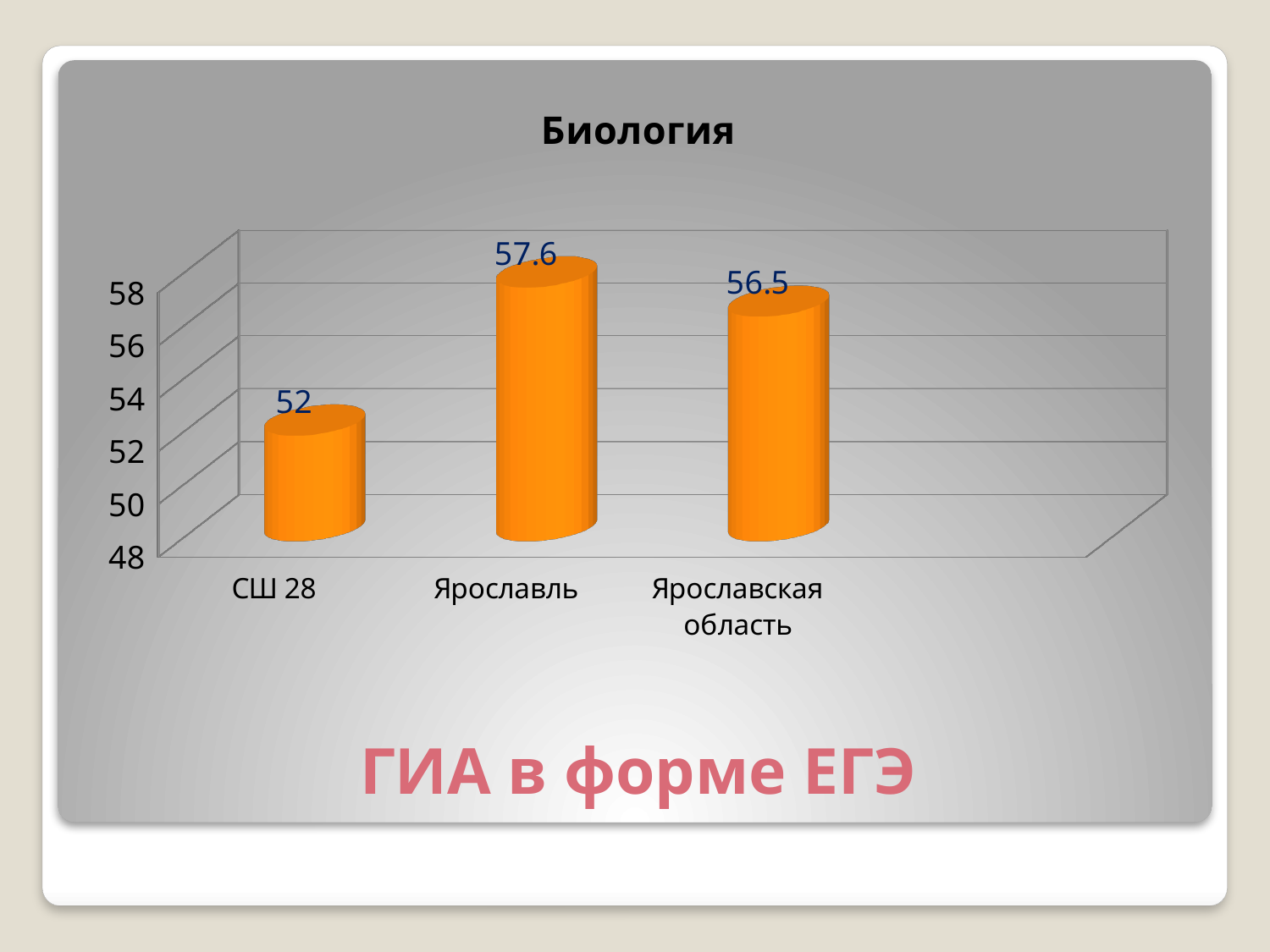
Which is larger, the value for Ярославская область or the value for СШ 28? Ярославская область Which category has the highest value? Ярославль What is the value for СШ 28? 52 Is the value for СШ 28 greater or less than 54? less What is the value for Ярославская область? 56.5 What is the title of the chart? Биология How many categories are shown on the chart? 3 What kind of chart is shown on the slide? bar chart What is the difference between the values for Ярославль and Ярославская область? 1.1 What is the difference between the values for Ярославль and СШ 28? 5.6 Which category has the lowest value? СШ 28 What is the value for Ярославль? 57.6